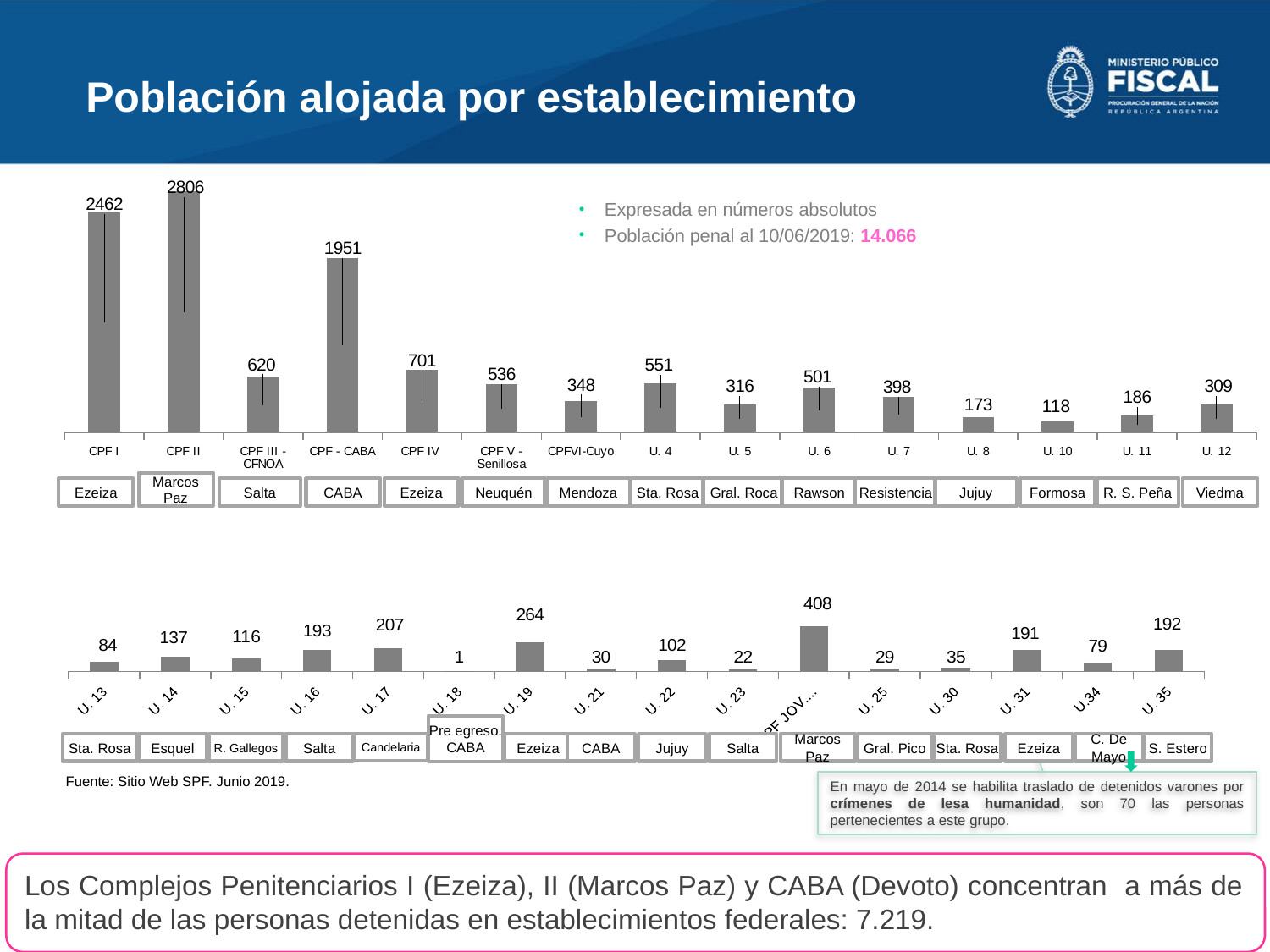
In the bottom chart, which unit has the lowest value? U. 18 What type of chart is the top chart? Bar chart In the top chart, which establishment has the lowest value? U. 10 How many establishments are shown in the top chart? 15 In the top chart, which is larger, the value for U. 4 or the value for U. 6? U. 4 In the top chart, which establishment has the highest value? CPF II In the top chart, what is the value for CPF - CABA? 1951 In the top chart, what is the value for CPF II? 2806 How many categories are shown in the bottom chart? 16 In the bottom chart, what is the difference between the values for U. 17 and U. 16? 14 In the bottom chart, what is the value for U. 19? 264 In the top chart, what is the difference between the values for CPF II and CPF I? 344